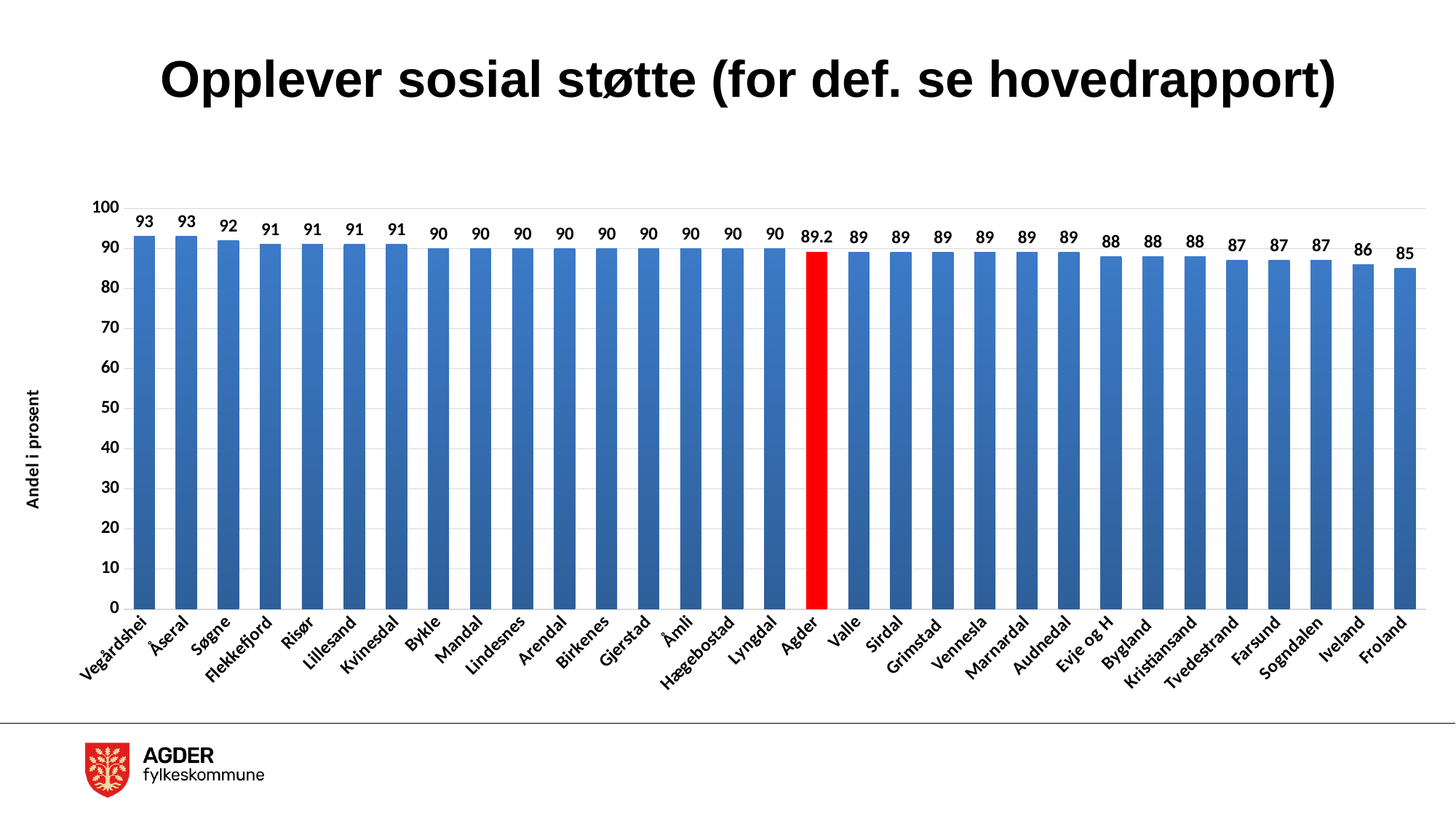
What is the difference between the values for Søgne and Tvedestrand? 5 How many categories are shown on the x axis? 31 What is the value for Søgne? 92 What is the value for Agder? 89.2 What is the value for Iveland? 86 What is the value for Kristiansand? 88 What is the difference between the values for Vegårdshei and Froland? 8 Which bar is coloured red instead of blue? Agder Is the value for Froland greater or less than 90? less Which has a larger value, Flekkefjord or Farsund? Flekkefjord What kind of chart is shown on the slide? bar chart Which category has the lowest value? Froland